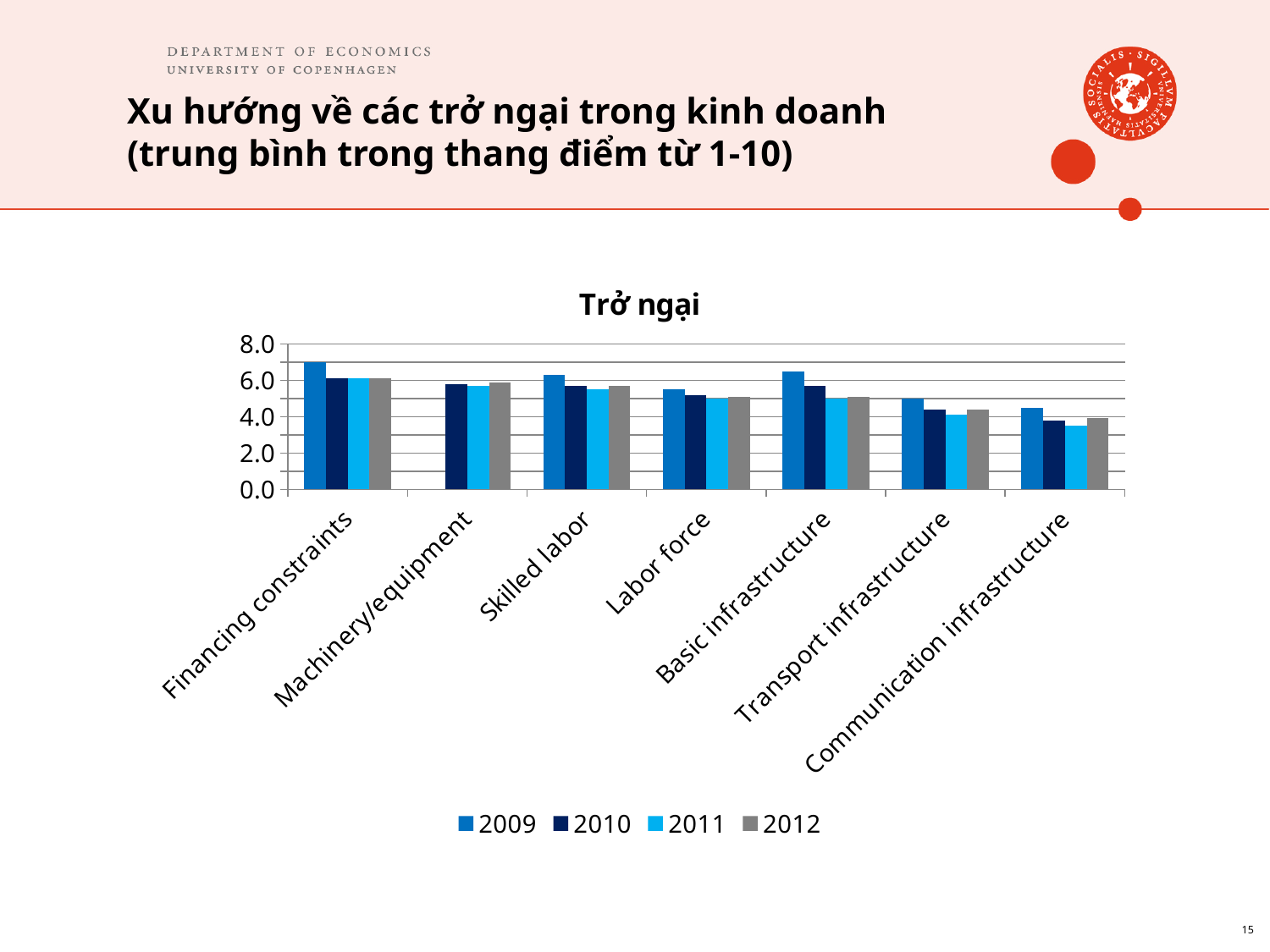
Which years are listed in the legend? 2009, 2010, 2011, 2012 Which category has the lowest 2011 value? Communication infrastructure How many categories are shown on the x axis? 7 Is the 2009 value for Financing constraints greater or less than 6.0? greater Is the 2009 value for Basic infrastructure greater or less than 6.0? greater For Communication infrastructure, is the 2010 value higher or lower than the 2009 value? lower What kind of chart is shown on the slide? bar chart Which category has the highest 2009 value? Financing constraints How many series does the legend list? 4 What is the title of the chart? Trở ngại Which is larger: the 2009 value for Financing constraints or the 2009 value for Communication infrastructure? Financing constraints Is the 2011 value for Communication infrastructure greater or less than 4.0? less